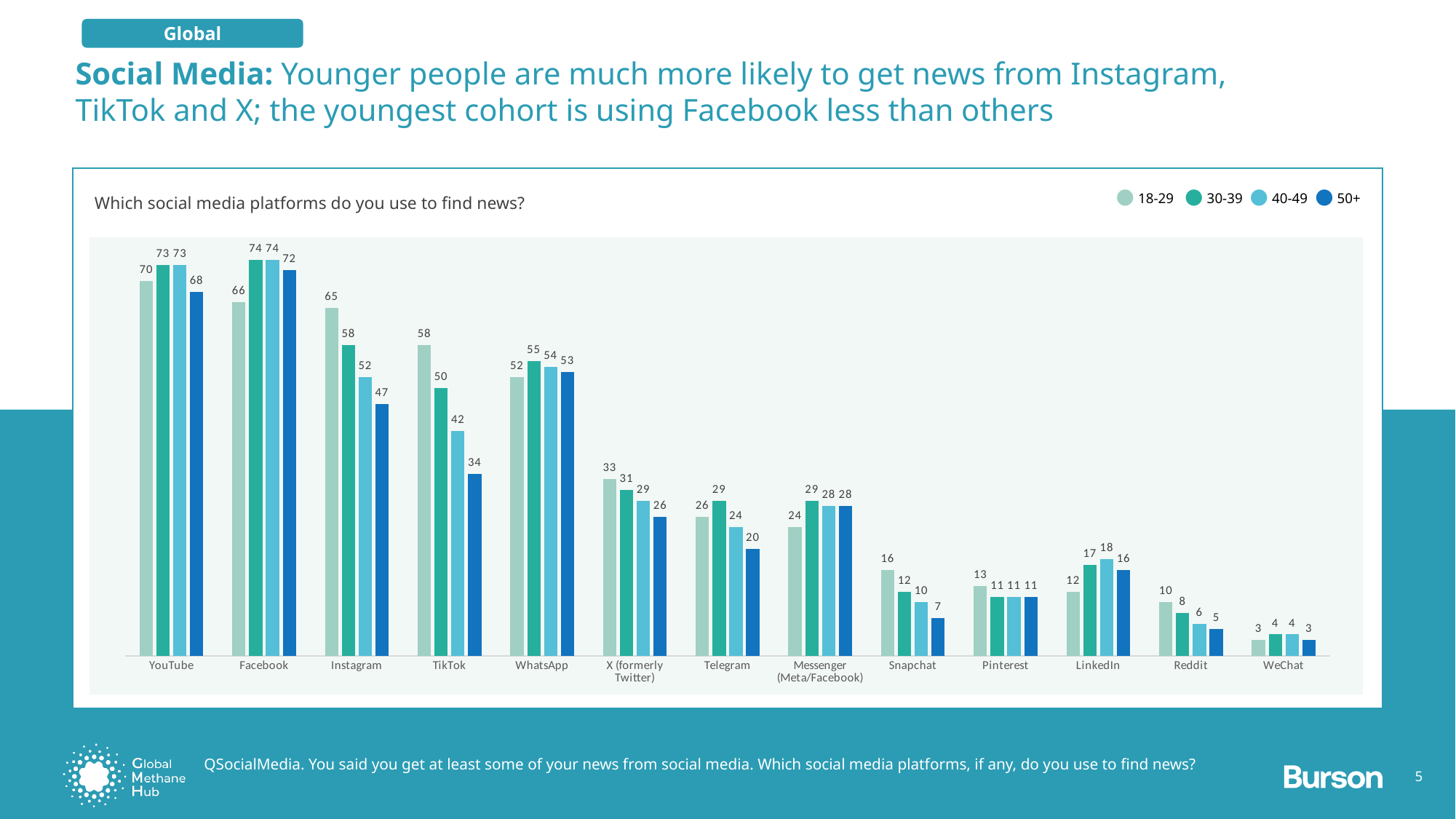
What is the value for the 40-49 age group for LinkedIn? 18 What is the value for the 50+ age group for TikTok? 34 Which platform has the lowest value for the 50+ age group? WeChat What question is the chart based on, as shown above the chart? Which social media platforms do you use to find news? How many age groups does the legend list? 4 What kind of chart is shown on the slide? Bar chart How many social media platforms are shown on the x axis? 13 What is the value for the 18-29 age group for Instagram? 65 Which platform has the highest value for the 18-29 age group? YouTube Which is larger for Facebook: the value for 18-29 or the value for 50+? 50+ What is the difference between the 18-29 and 50+ values for TikTok? 24 For Instagram, do the values rise or fall as the age group gets older? Fall